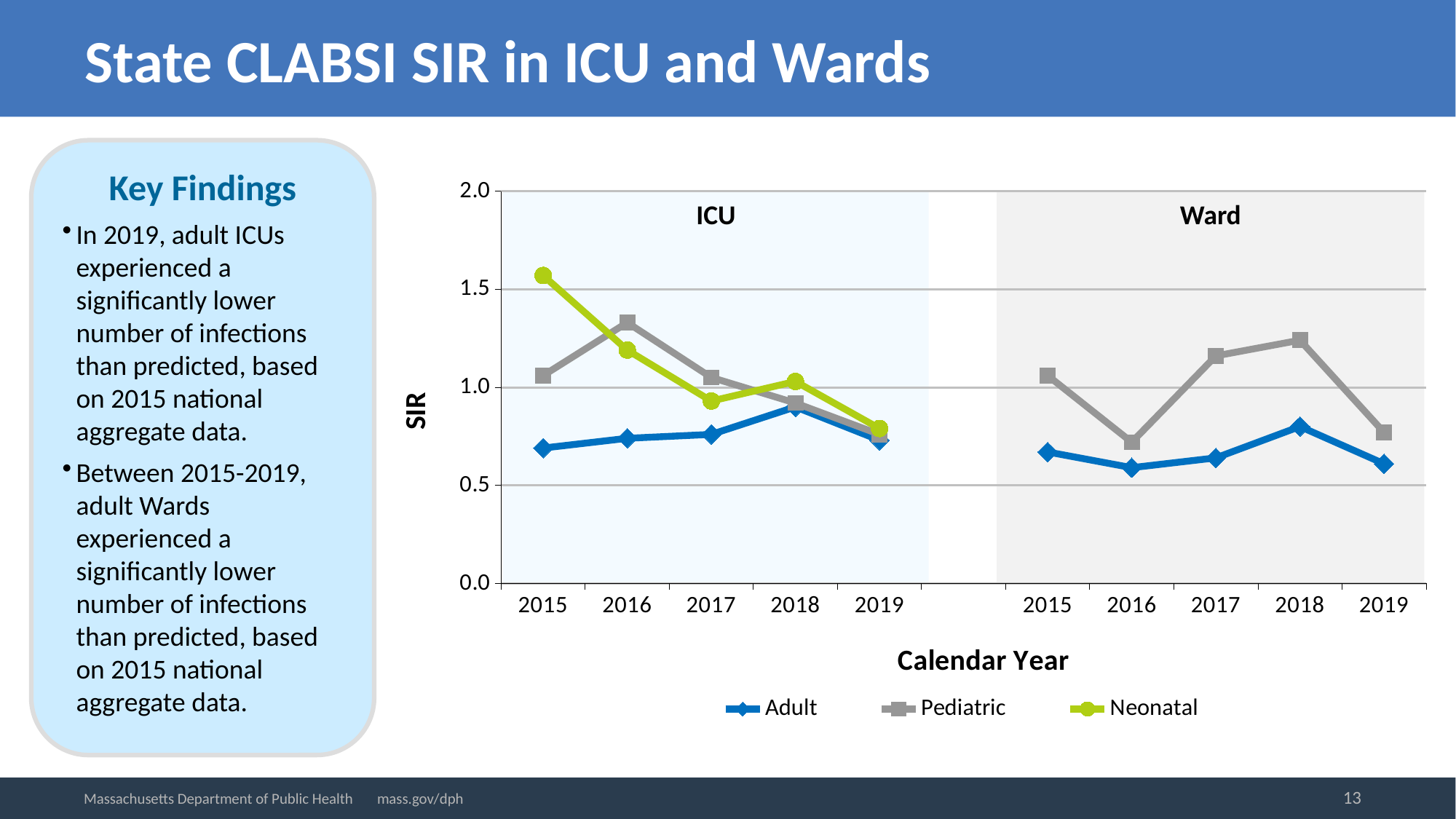
How many calendar years are plotted in the ICU panel? 5 What kind of chart is shown on the slide? line chart In the ICU panel, in which year is the Neonatal SIR highest? 2015 Is the Neonatal SIR in the ICU panel for 2015 greater or less than 1.5? greater Is the Adult SIR in the Ward panel for 2016 greater or less than 1.0? less In the ICU panel, in which year is the Adult SIR highest? 2018 Does the Neonatal SIR in the ICU panel rise or fall from 2015 to 2017? fall Is the Pediatric SIR in the ICU panel for 2016 greater or less than 1.0? greater What is the title of the x axis? Calendar Year How many series does the legend list? 3 In the Ward panel, in which year is the Pediatric SIR highest? 2018 In the ICU panel for 2015, which is larger: the Pediatric SIR or the Neonatal SIR? Neonatal